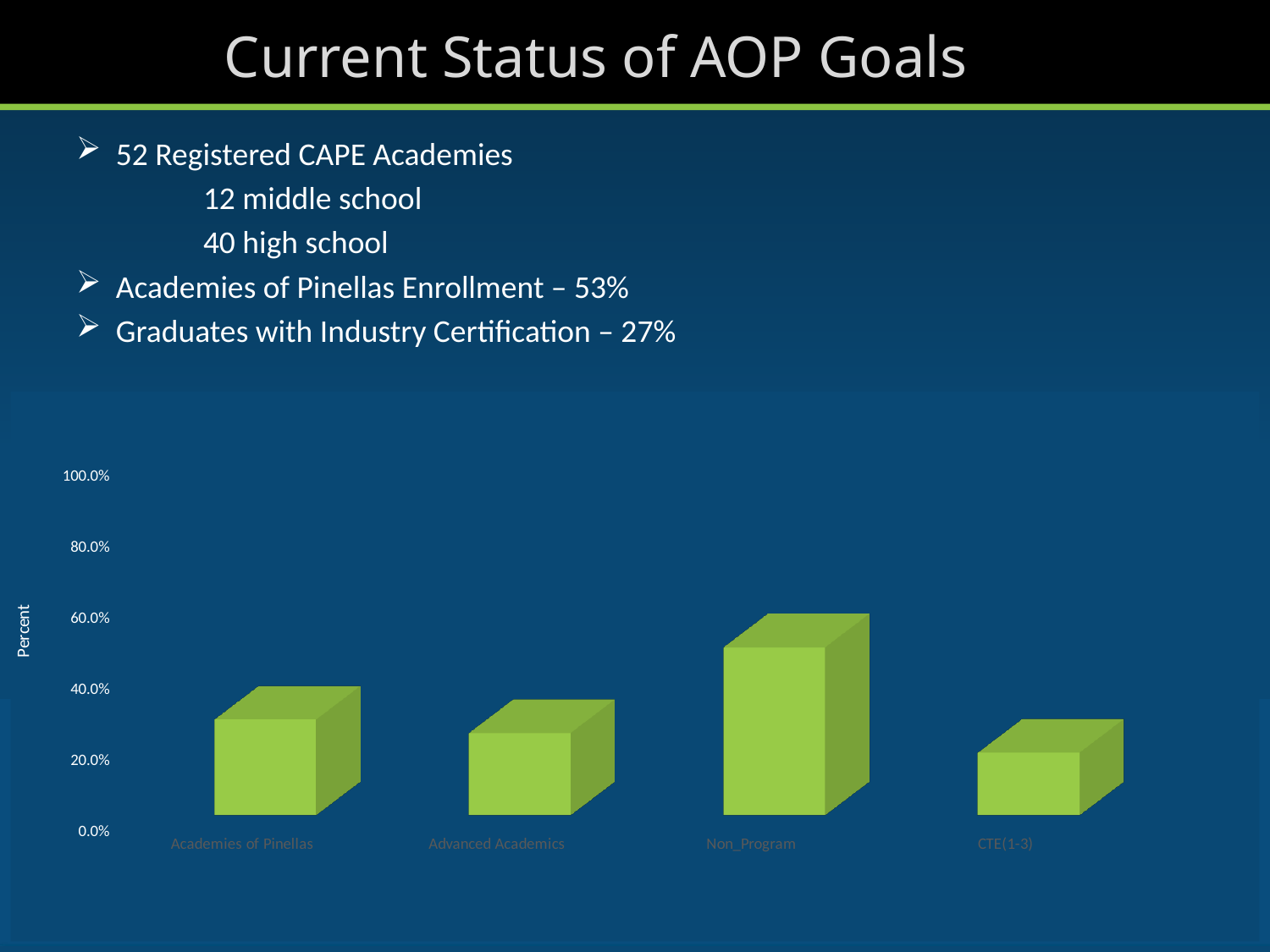
Is the value for Advanced Academics greater or less than 60.0%? less Which is larger, the value for Non_Program or the value for Advanced Academics? Non_Program Which is larger, the value for Academies of Pinellas or the value for CTE(1-3)? Academies of Pinellas Is the value for CTE(1-3) greater or less than 40.0%? less Is the value for Non_Program greater or less than 80.0%? less Which category has the highest value on the chart? Non_Program What kind of chart is shown on the slide? bar chart What is the title of the vertical axis of the chart? Percent Which category has the lowest value on the chart? CTE(1-3) How many categories are plotted on the chart? 4